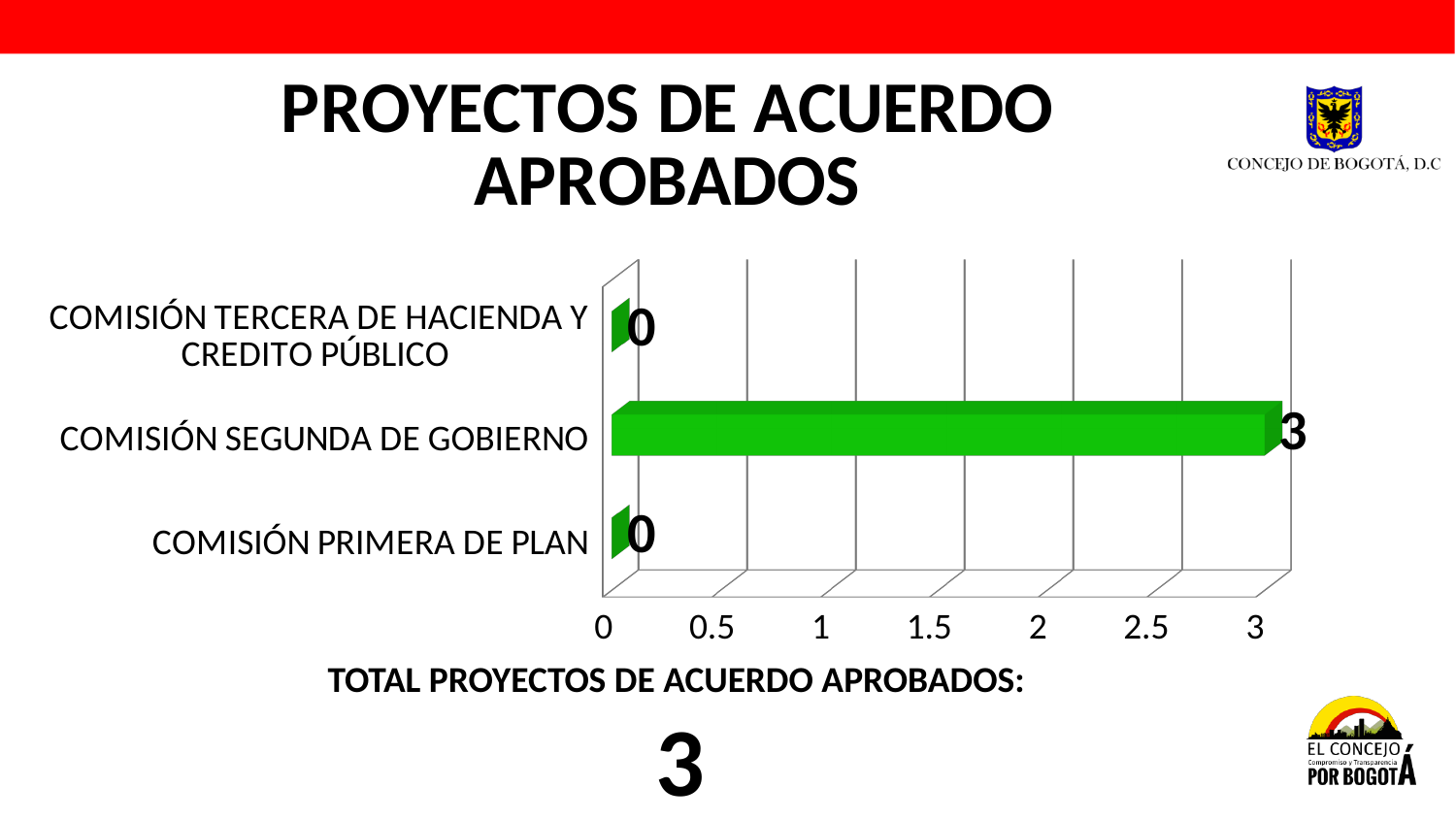
What colour are the bars in the chart? green What is the value for COMISIÓN PRIMERA DE PLAN? 0 Is the value for COMISIÓN SEGUNDA DE GOBIERNO greater or less than 2? greater Which is larger, the value for COMISIÓN SEGUNDA DE GOBIERNO or the value for COMISIÓN TERCERA DE HACIENDA Y CREDITO PÚBLICO? COMISIÓN SEGUNDA DE GOBIERNO What is the value for COMISIÓN SEGUNDA DE GOBIERNO? 3 Which category has the highest value? COMISIÓN SEGUNDA DE GOBIERNO How many categories are shown in the chart? 3 What kind of chart is shown on the slide? bar chart What is the value for COMISIÓN TERCERA DE HACIENDA Y CREDITO PÚBLICO? 0 What is the total of all the values shown in the chart? 3 What is the maximum value shown on the horizontal axis? 3 What is the difference between the values for COMISIÓN SEGUNDA DE GOBIERNO and COMISIÓN PRIMERA DE PLAN? 3